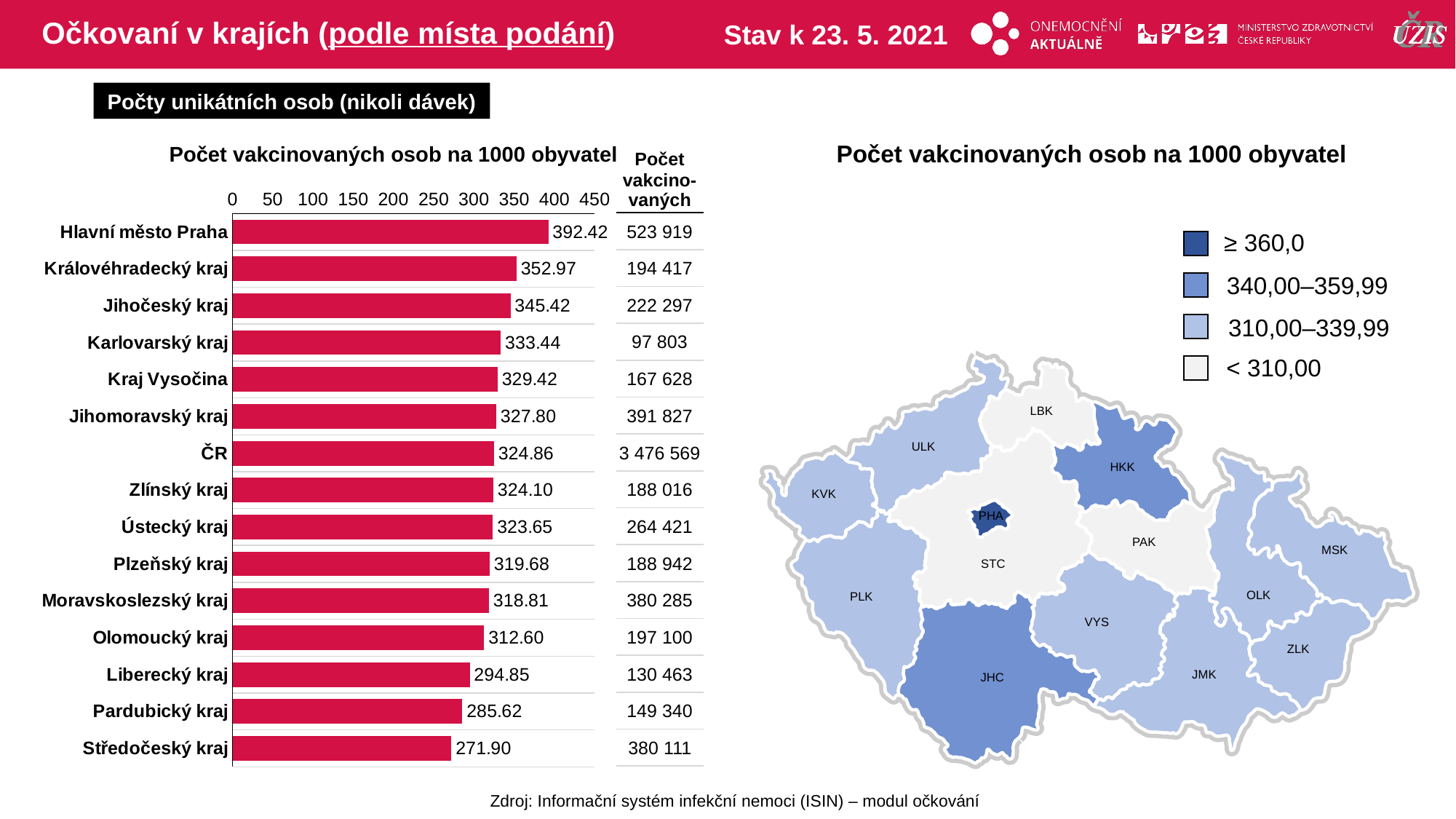
In the bar chart 'Počet vakcinovaných osob na 1000 obyvatel', which region has the lowest value? Středočeský kraj How many bars are shown in the bar chart 'Počet vakcinovaných osob na 1000 obyvatel'? 15 In the bar chart 'Počet vakcinovaných osob na 1000 obyvatel', what is the difference between the values for Hlavní město Praha and Středočeský kraj? 120.52 In the bar chart 'Počet vakcinovaných osob na 1000 obyvatel', which region has the highest value? Hlavní město Praha In the bar chart 'Počet vakcinovaných osob na 1000 obyvatel', what is the difference between the values for Olomoucký kraj and Pardubický kraj? 26.98 In the bar chart 'Počet vakcinovaných osob na 1000 obyvatel', is the value for Liberecký kraj greater or less than 300? less In the bar chart 'Počet vakcinovaných osob na 1000 obyvatel', what is the value for Hlavní město Praha? 392.42 In the bar chart 'Počet vakcinovaných osob na 1000 obyvatel', which is larger: the value for Královéhradecký kraj or the value for Jihočeský kraj? Královéhradecký kraj In the bar chart 'Počet vakcinovaných osob na 1000 obyvatel', what is the value for ČR? 324.86 What kind of chart is the chart on the left side of the slide? bar chart What is the highest tick value shown on the horizontal axis of the bar chart 'Počet vakcinovaných osob na 1000 obyvatel'? 450 In the bar chart 'Počet vakcinovaných osob na 1000 obyvatel', what is the value for Jihomoravský kraj? 327.80